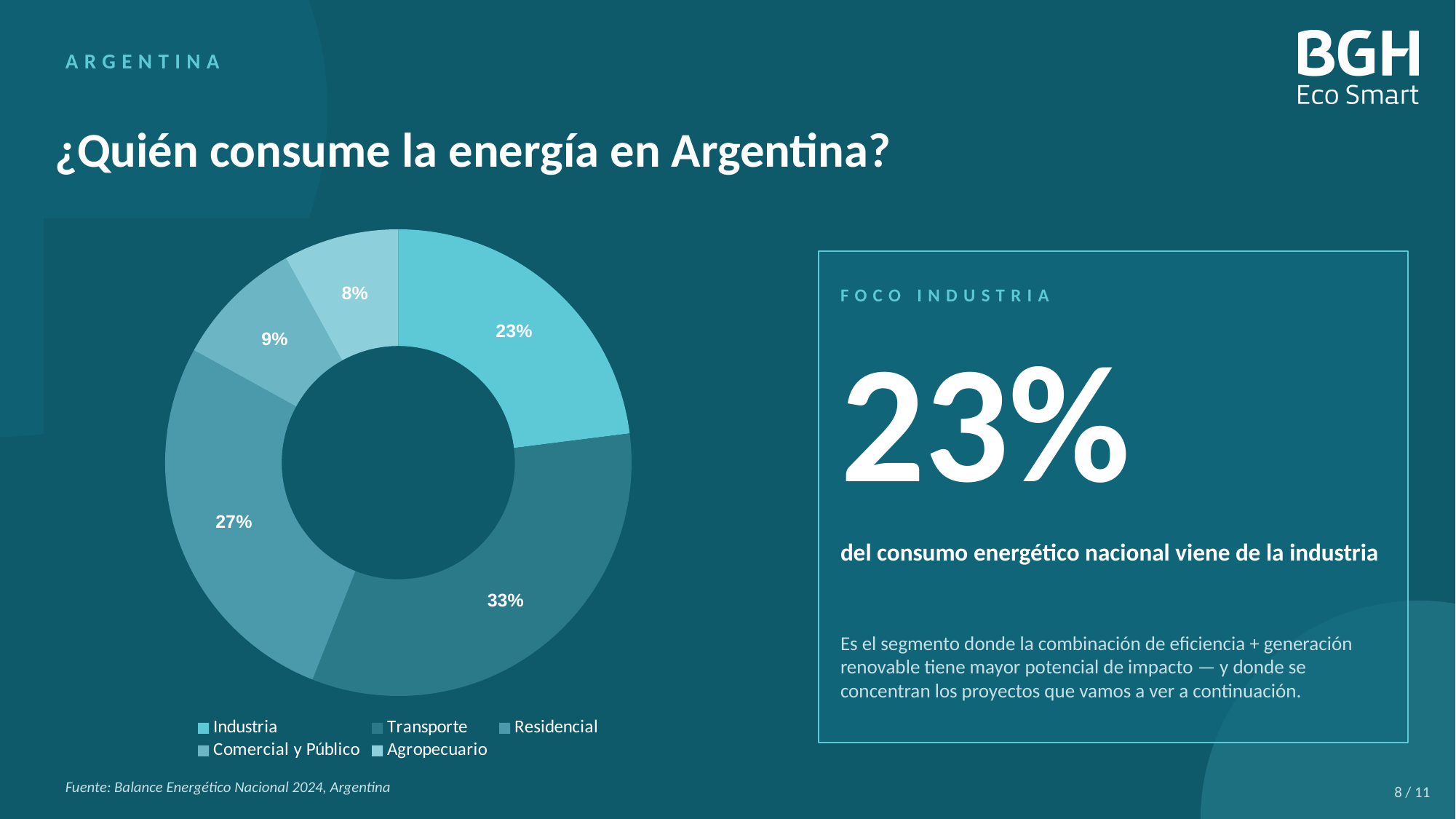
What share of energy consumption does Residencial account for? 27% What is the difference in percentage points between Transporte and Industria? 10 Which is larger, the share for Residencial or the share for Industria? Residencial What share of energy consumption does Transporte account for? 33% What type of chart is shown on the slide? Pie chart (donut) What is the source cited below the chart? Balance Energético Nacional 2024, Argentina What share of energy consumption does Agropecuario account for? 8% Which category has the largest share of energy consumption? Transporte Which category has the smallest share of energy consumption? Agropecuario How many categories are shown in the chart? 5 What share of energy consumption does Industria account for? 23% What is the combined share of Comercial y Público and Agropecuario? 17%